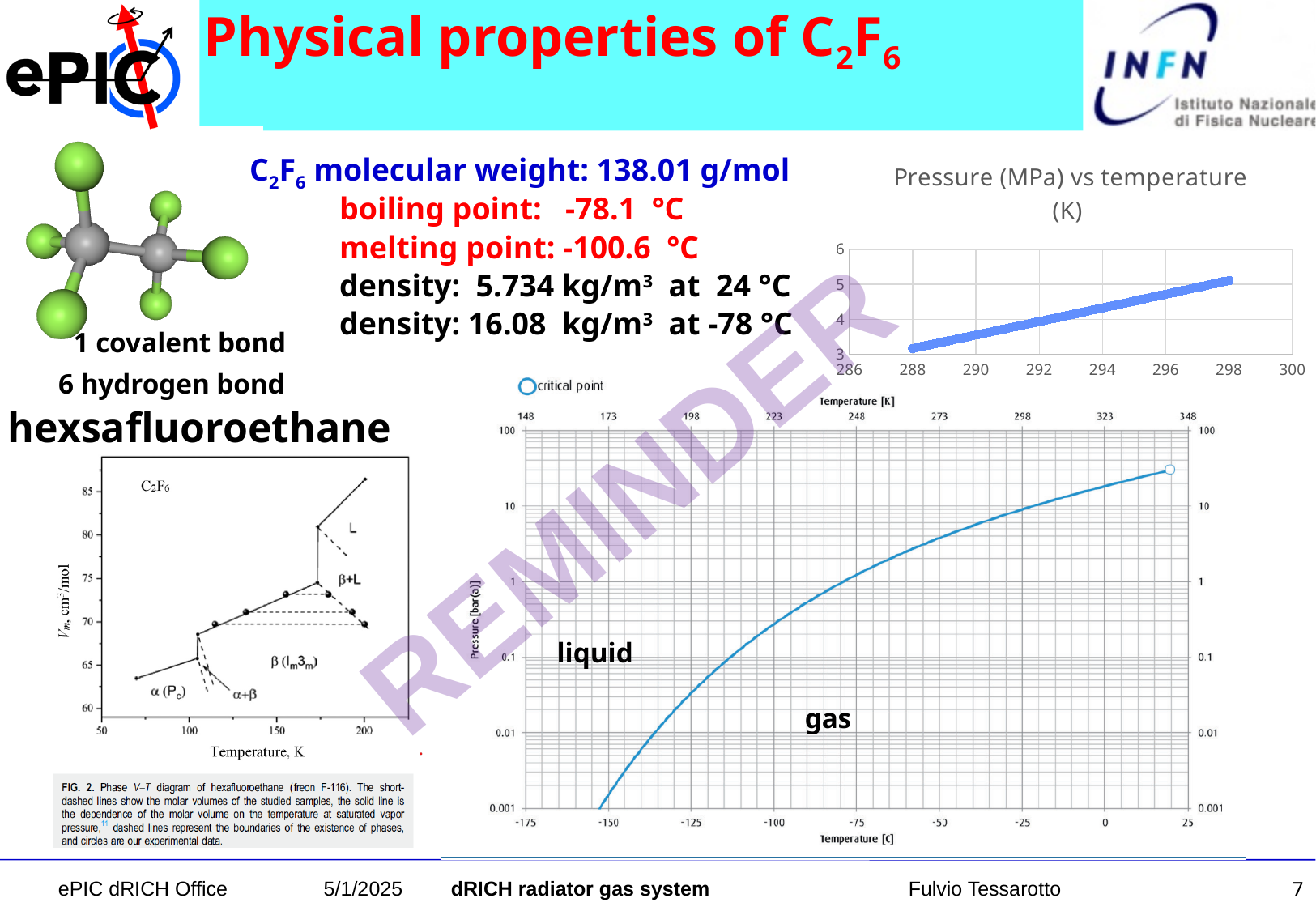
In the 'Pressure (MPa) vs temperature (K)' chart, do the values rise or fall as temperature increases? rise In the bottom-right pressure vs temperature chart, is the pressure at -50 °C greater or less than 1 bar? greater In the bottom-right pressure vs temperature chart, does the pressure rise or fall as temperature increases? rise In the bottom-right pressure vs temperature chart, is the pressure at -150 °C greater or less than 0.01 bar? less In the bottom-right pressure vs temperature chart, is the pressure at -100 °C greater or less than 0.1 bar? greater What kind of chart is the 'Pressure (MPa) vs temperature (K)' chart? line chart In the 'Pressure (MPa) vs temperature (K)' chart, what is the highest value shown on the vertical axis? 6 What is the title of the chart in the top right of the slide? Pressure (MPa) vs temperature (K) In the bottom-left V-T diagram of hexafluoroethane, does the molar volume rise or fall as temperature increases? rise